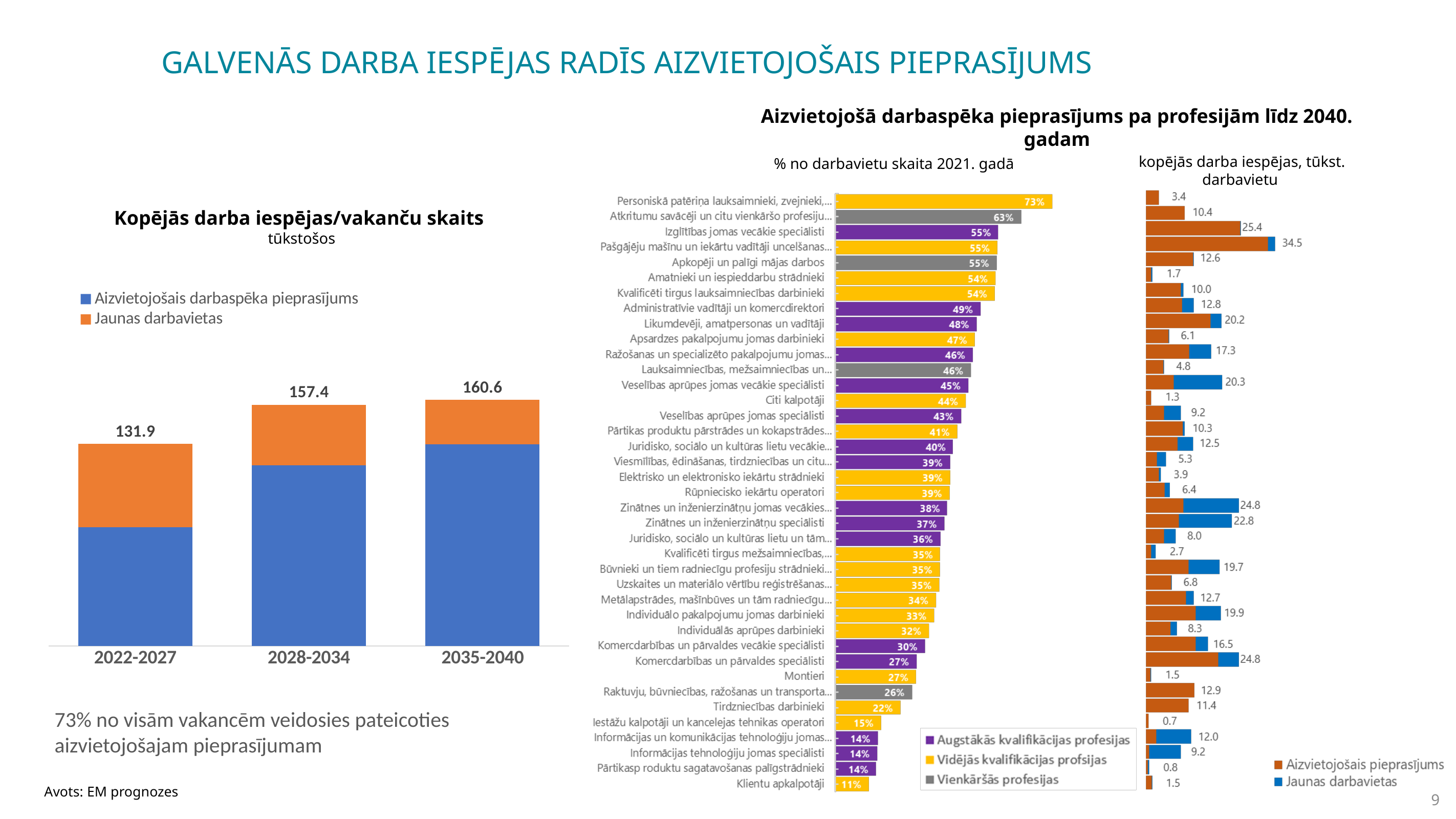
In the chart 'Kopējās darba iespējas/vakanču skaits', what is the difference between the totals for 2035-2040 and 2022-2027? 28.7 In the chart 'Kopējās darba iespējas/vakanču skaits', which period has the highest total? 2035-2040 In the chart 'Kopējās darba iespējas/vakanču skaits', what is the total value shown for 2022-2027? 131.9 What kind of chart is 'Kopējās darba iespējas/vakanču skaits'? bar chart In the chart '% no darbavietu skaita 2021. gadā', how many series does the legend list? 3 In the chart 'kopējās darba iespējas, tūkst. darbavietu', what is the value for Izglītības jomas vecākie speciālisti? 25.4 In the chart '% no darbavietu skaita 2021. gadā', which profession has the highest value? Personiskā patēriņa lauksaimnieki, zvejnieki,... In the chart '% no darbavietu skaita 2021. gadā', what is the value for Klientu apkalpotāji? 11% In the chart 'Kopējās darba iespējas/vakanču skaits', do the totals rise or fall from 2022-2027 to 2035-2040? rise In the chart '% no darbavietu skaita 2021. gadā', what is the value for Tirdzniecības darbinieki? 22% In the chart 'Kopējās darba iespējas/vakanču skaits', how many series does the legend list? 2 In the chart 'kopējās darba iespējas, tūkst. darbavietu', what is the highest value shown? 34.5